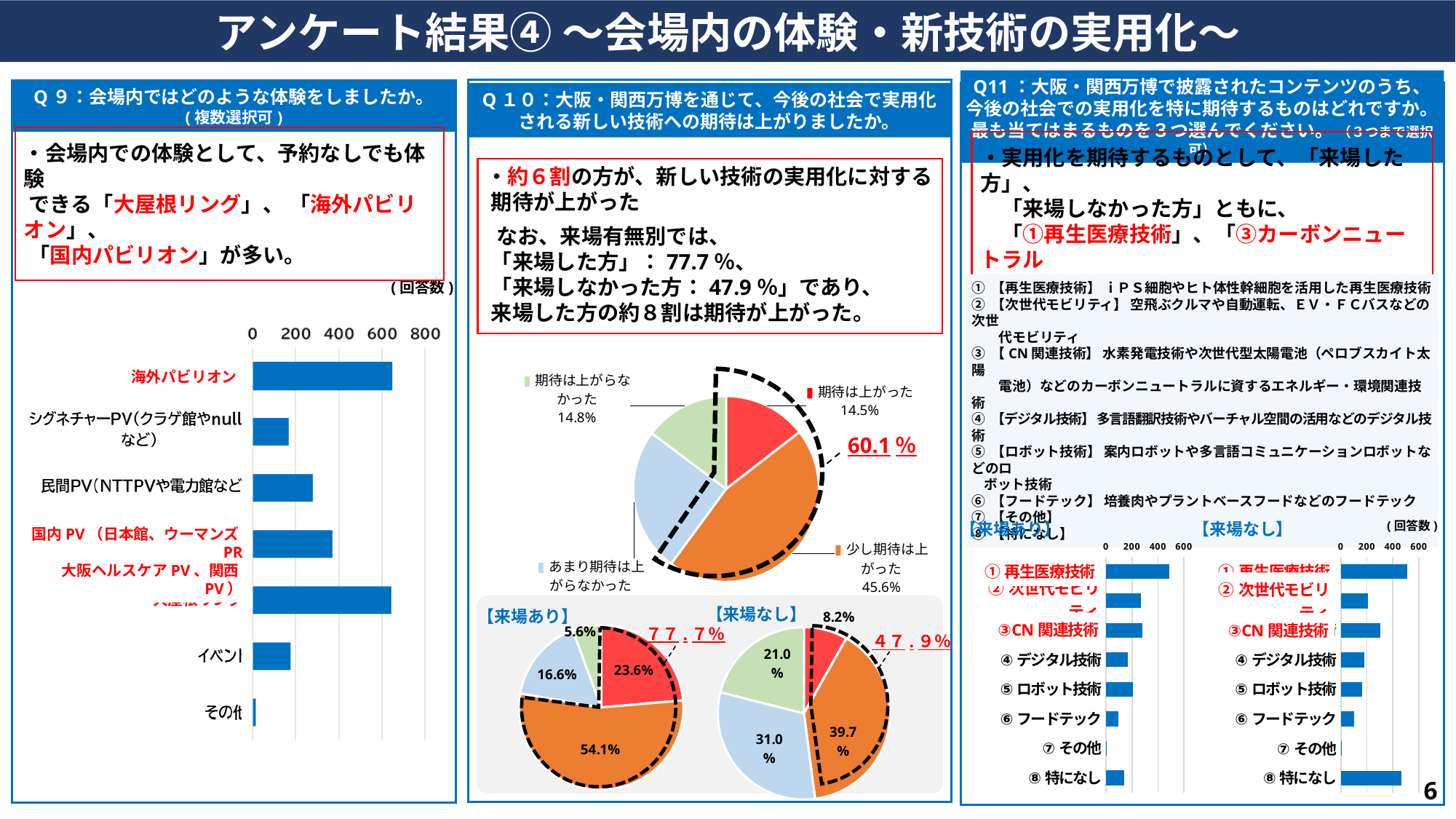
What type of chart is used in the Q9 panel (会場内ではどのような体験をしましたか)? bar chart In the Q11 【来場なし】 bar chart, is the value for ①再生医療技術 greater or less than 400? greater In the Q9 bar chart, is the value for イベント greater or less than 200? less In the main Q10 pie chart, what share is labelled for 期待は上がらなかった? 14.8% In the Q11 【来場あり】 bar chart, which item has the highest number of responses? ①再生医療技術 In the Q10 【来場なし】 pie chart, what percentage is shown for the orange slice? 39.7% In the main Q10 pie chart, what share is labelled for 少し期待は上がった? 45.6% In the Q10 【来場あり】 pie chart, what is the largest slice's percentage? 54.1% In the Q9 bar chart, which category has the lowest number of responses? その他 In the Q9 bar chart, is the value for 海外パビリオン greater or less than 600? greater In the Q9 bar chart, which has more responses: 民間PV(NTTPVや電力館など) or シグネチャーPV(クラゲ館やnullなど)? 民間PV(NTTPVや電力館など) How many categories (bars) are shown in the Q9 bar chart? 7